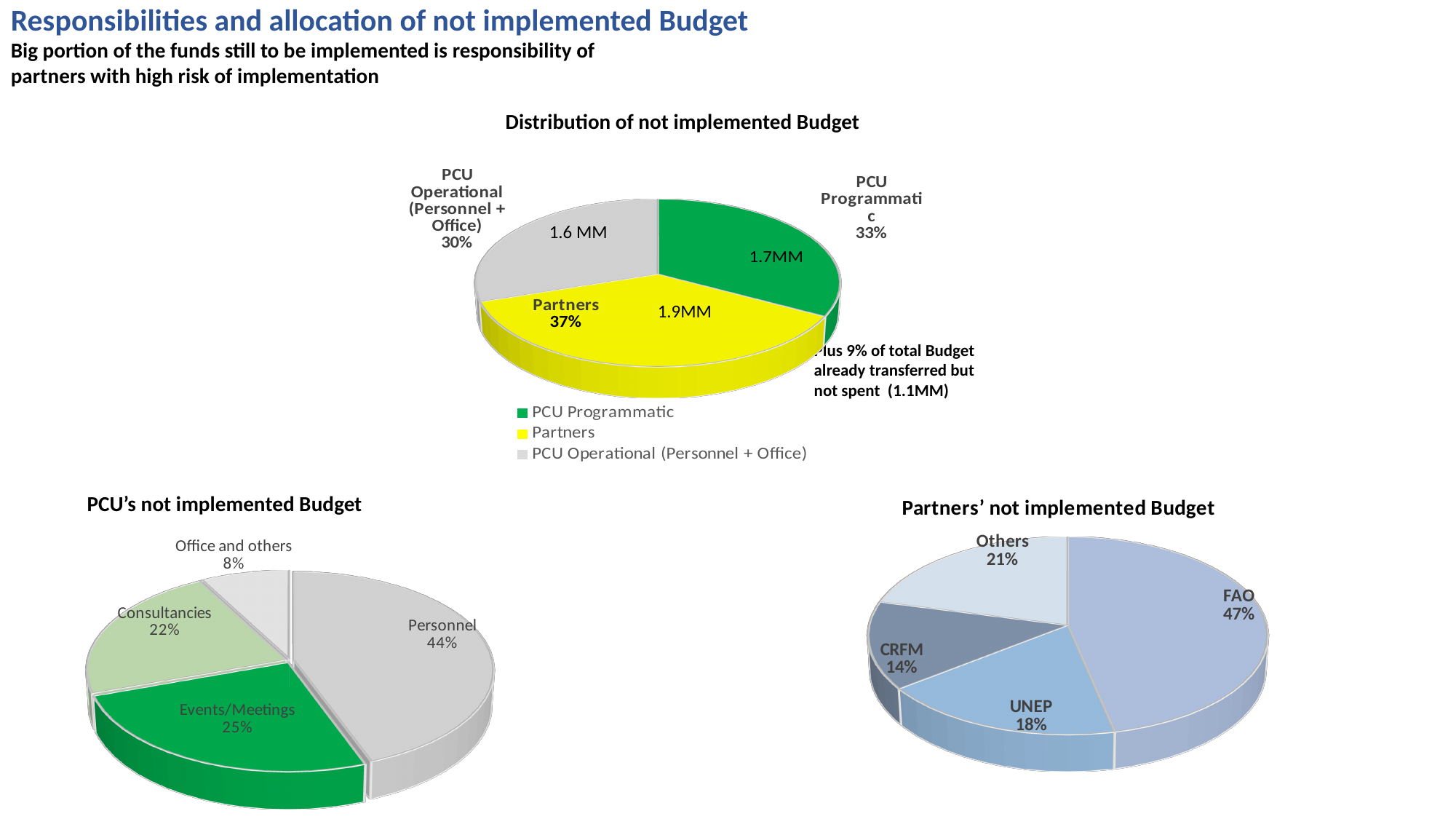
In the 'Partners' not implemented Budget' chart, what share is FAO? 47% In the 'PCU's not implemented Budget' chart, what share is Events/Meetings? 25% In the 'PCU's not implemented Budget' chart, what is the difference in percentage points between Personnel and Consultancies? 22 In the 'Distribution of not implemented Budget' chart, what share of the pie is Partners? 37% What kind of chart is 'PCU's not implemented Budget'? Pie chart In the 'Distribution of not implemented Budget' chart, how many entries does the legend list? 3 In the 'Partners' not implemented Budget' chart, which is larger, UNEP or CRFM? UNEP In the 'Distribution of not implemented Budget' chart, what value is shown for PCU Programmatic? 1.7MM In the 'Partners' not implemented Budget' chart, how many categories are shown? 4 In the 'Distribution of not implemented Budget' chart, what value is shown for PCU Operational (Personnel + Office)? 1.6 MM In the 'Distribution of not implemented Budget' chart, which category has the largest share? Partners In the 'PCU's not implemented Budget' chart, which category has the smallest share? Office and others